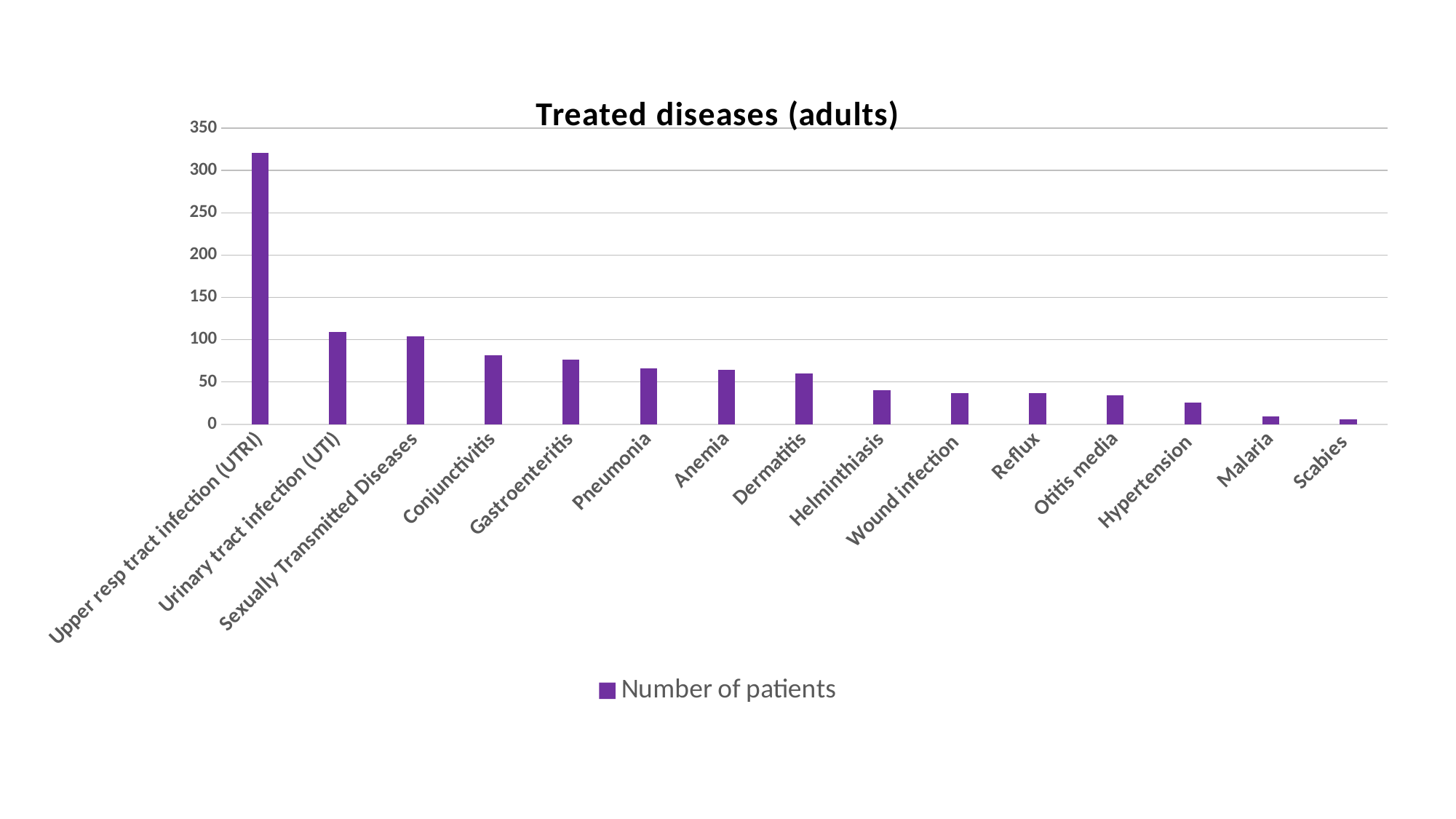
How many disease categories are shown on the x axis? 15 How many series does the legend list? 1 Is the value for Conjunctivitis greater or less than 100? less Which disease has the highest number of patients? Upper resp tract infection (UTRI) Is the value for Upper resp tract infection (UTRI) greater or less than 300? greater Which has more patients, Pneumonia or Helminthiasis? Pneumonia Is the value for Hypertension greater or less than 50? less Do the values generally rise or fall from left to right along the x axis? fall What is the title of the chart? Treated diseases (adults) Which disease has the lowest number of patients? Scabies What kind of chart is shown on the slide? bar chart